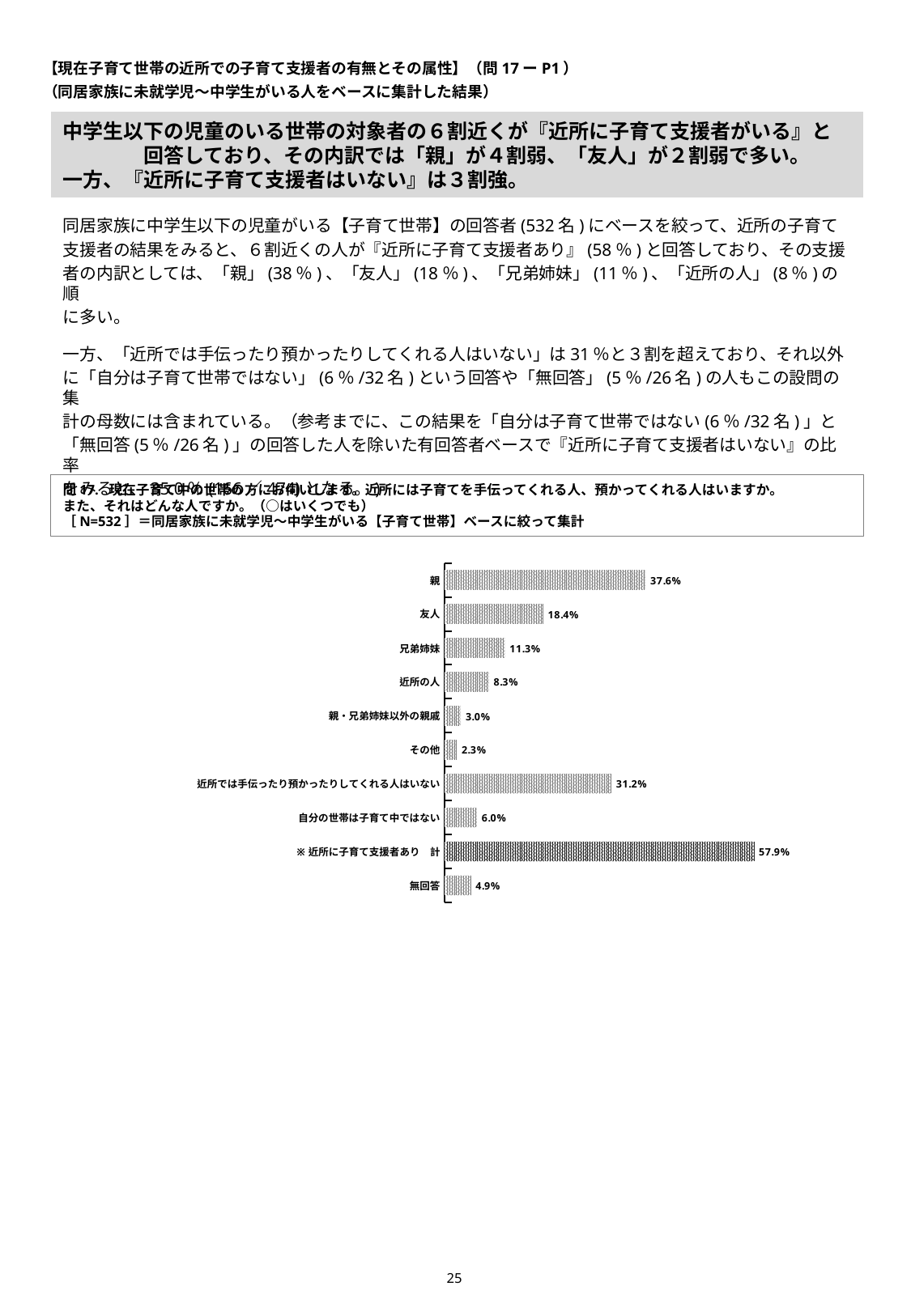
What is the value for 無回答 in the chart? 4.9% What is the difference between the values for 親 and 友人? 19.2 percentage points How many categories are shown in the chart? 10 What is the value for 兄弟姉妹 in the chart? 11.3% Which category has the lowest value in the chart? その他 Which is larger, the value for 近所の人 or the value for 自分の世帯は子育て中ではない? 近所の人 What is the value for 親 in the chart? 37.6% What is the sample size (N) stated for the chart? N=532 What is the value for 近所では手伝ったり預かったりしてくれる人はいない in the chart? 31.2% What kind of chart is shown on the slide? bar chart Which category has the highest value in the chart? ※近所に子育て支援者あり 計 What is the value for 友人 in the chart? 18.4%